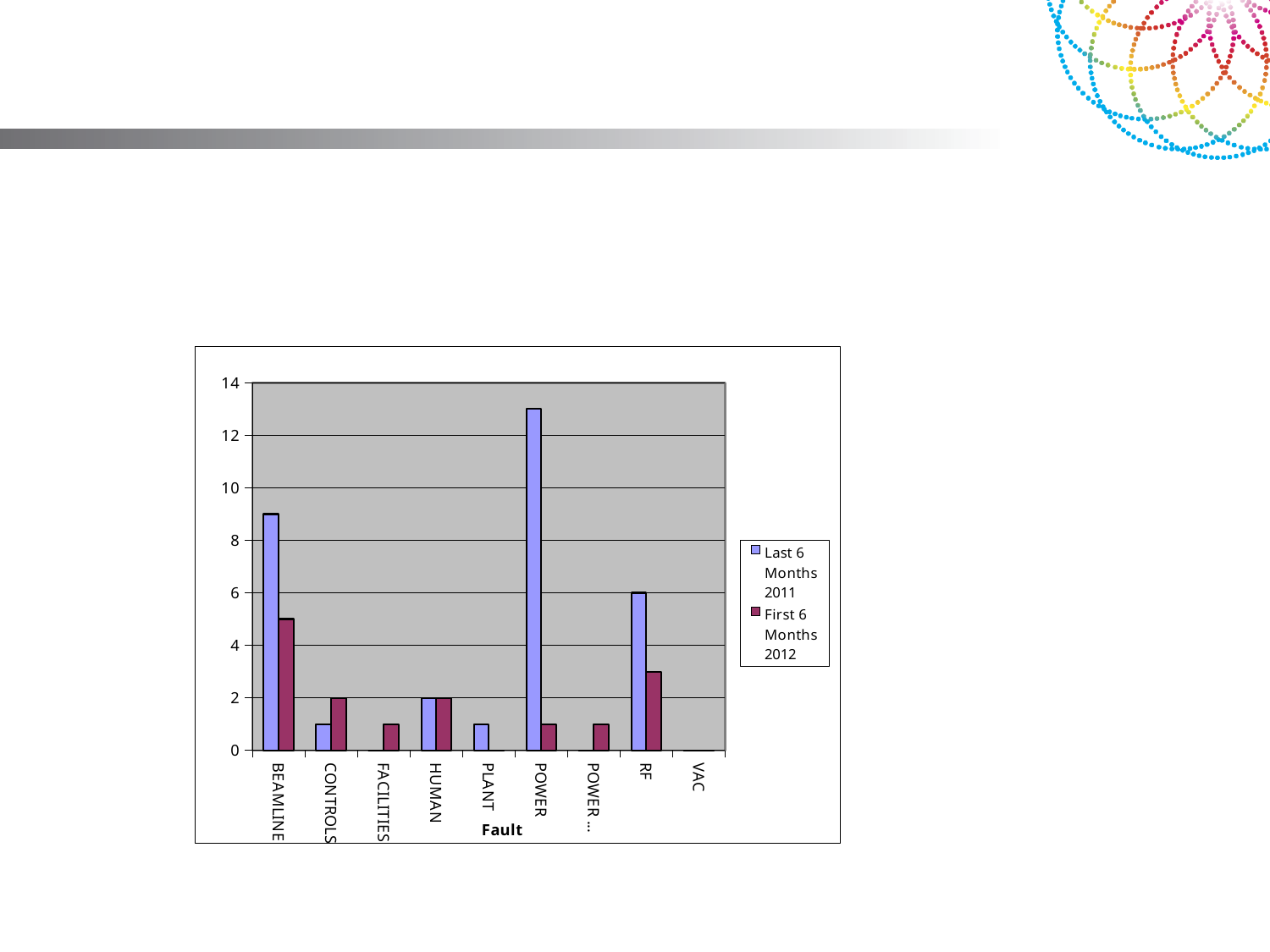
What is the value for HUMAN in First 6 Months 2012? 2 Is the value for BEAMLINE in Last 6 Months 2011 greater or less than 8? greater What kind of chart is shown on the slide? bar chart Which fault category has the highest value for First 6 Months 2012? BEAMLINE Which fault category has the highest value for Last 6 Months 2011? POWER How many fault categories are shown on the x axis? 9 Is the value for POWER in Last 6 Months 2011 greater or less than 12? greater How many series does the legend list? 2 For BEAMLINE, which series has the larger value, Last 6 Months 2011 or First 6 Months 2012? Last 6 Months 2011 What is the value for CONTROLS in First 6 Months 2012? 2 What is the difference between the Last 6 Months 2011 values for RF and HUMAN? 4 What is the value for RF in Last 6 Months 2011? 6